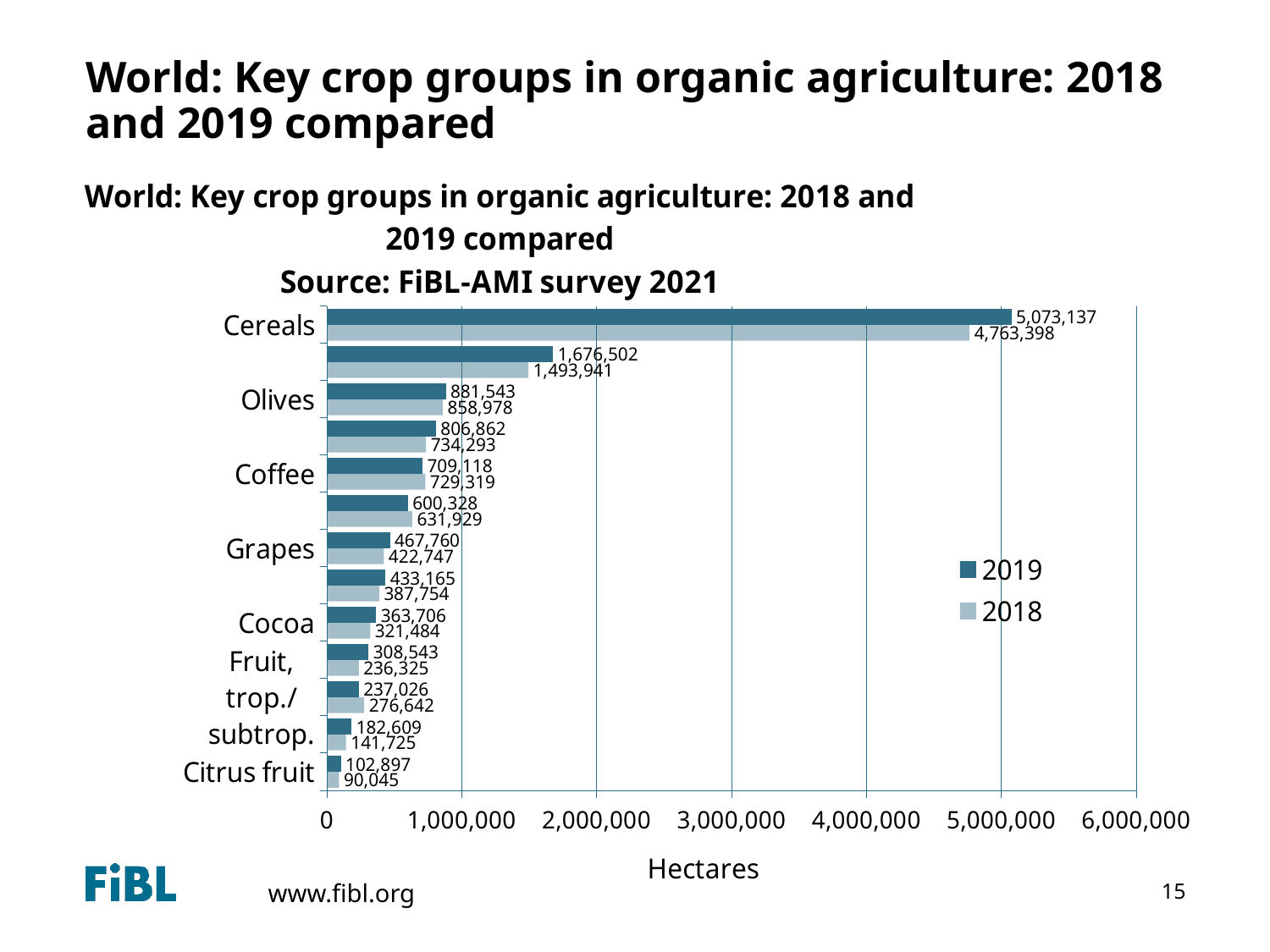
Which crop group has the highest 2019 value? Cereals What is the 2019 value for Cereals? 5,073,137 What is the 2019 value for Citrus fruit? 102,897 What is the 2018 value for Coffee? 729,319 What is the label of the horizontal axis? Hectares Which crop group has the lowest 2019 value? Citrus fruit What is the 2018 value for Cereals? 4,763,398 What is the 2019 value for Olives? 881,543 For Coffee, which year has the larger value, 2019 or 2018? 2018 How many series does the legend list? 2 What is the difference between the 2019 and 2018 values for Cereals? 309,739 What kind of chart is shown on the slide? Bar chart